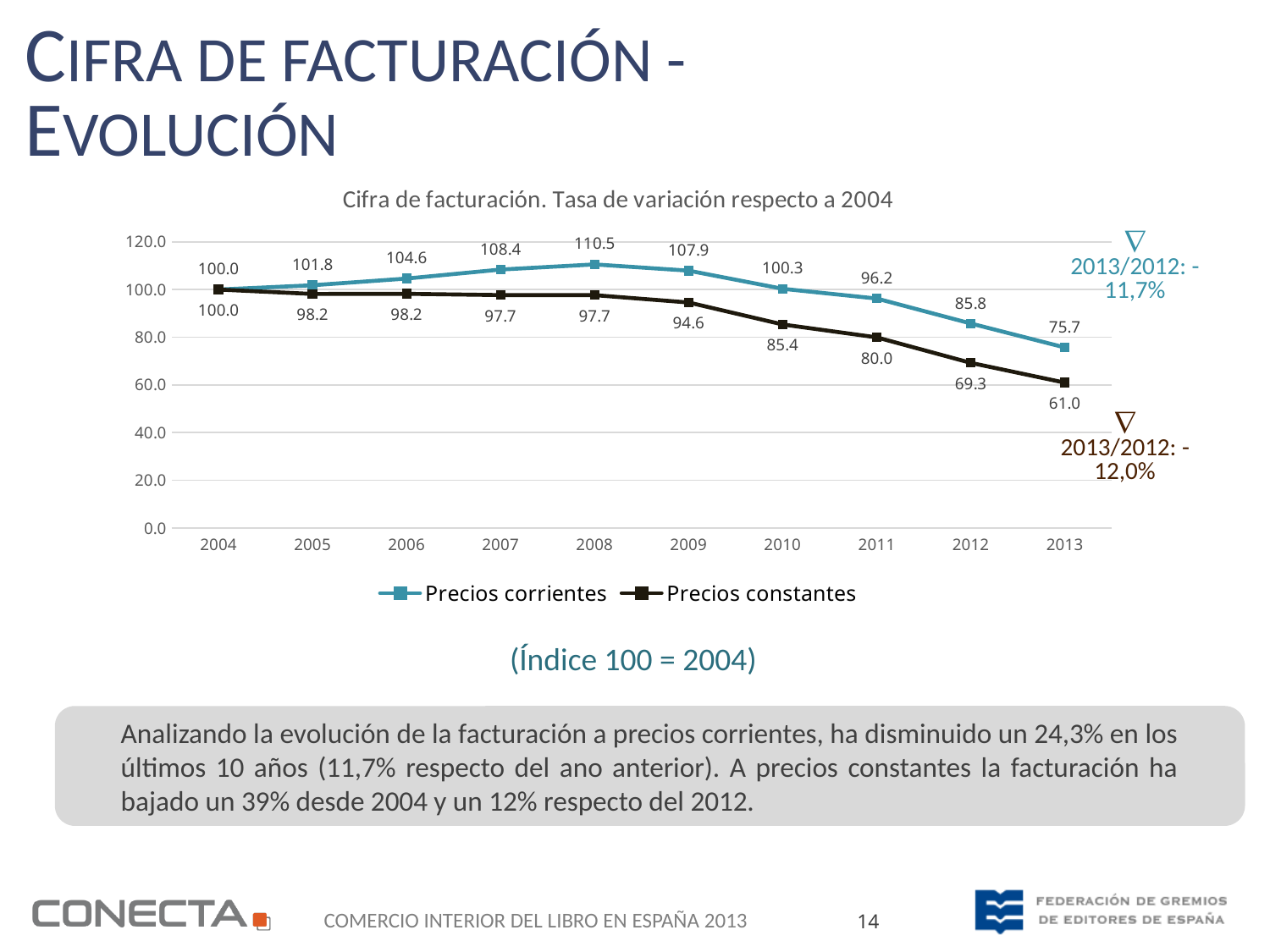
What is the title of the chart? Cifra de facturación. Tasa de variación respecto a 2004 What is the value for Precios constantes in 2010? 85.4 How many series does the legend list? 2 What kind of chart is shown on the slide? Line chart What is the value for Precios constantes in 2013? 61.0 In which year is Precios constantes at its lowest value? 2013 Which series has the larger value in 2011, Precios corrientes or Precios constantes? Precios corrientes In which year does Precios corrientes reach its highest value? 2008 Does Precios constantes rise or fall from 2009 to 2013? Fall What is the difference between Precios corrientes and Precios constantes in 2012? 16.5 How many years are shown on the x axis? 10 What is the value for Precios corrientes in 2008? 110.5